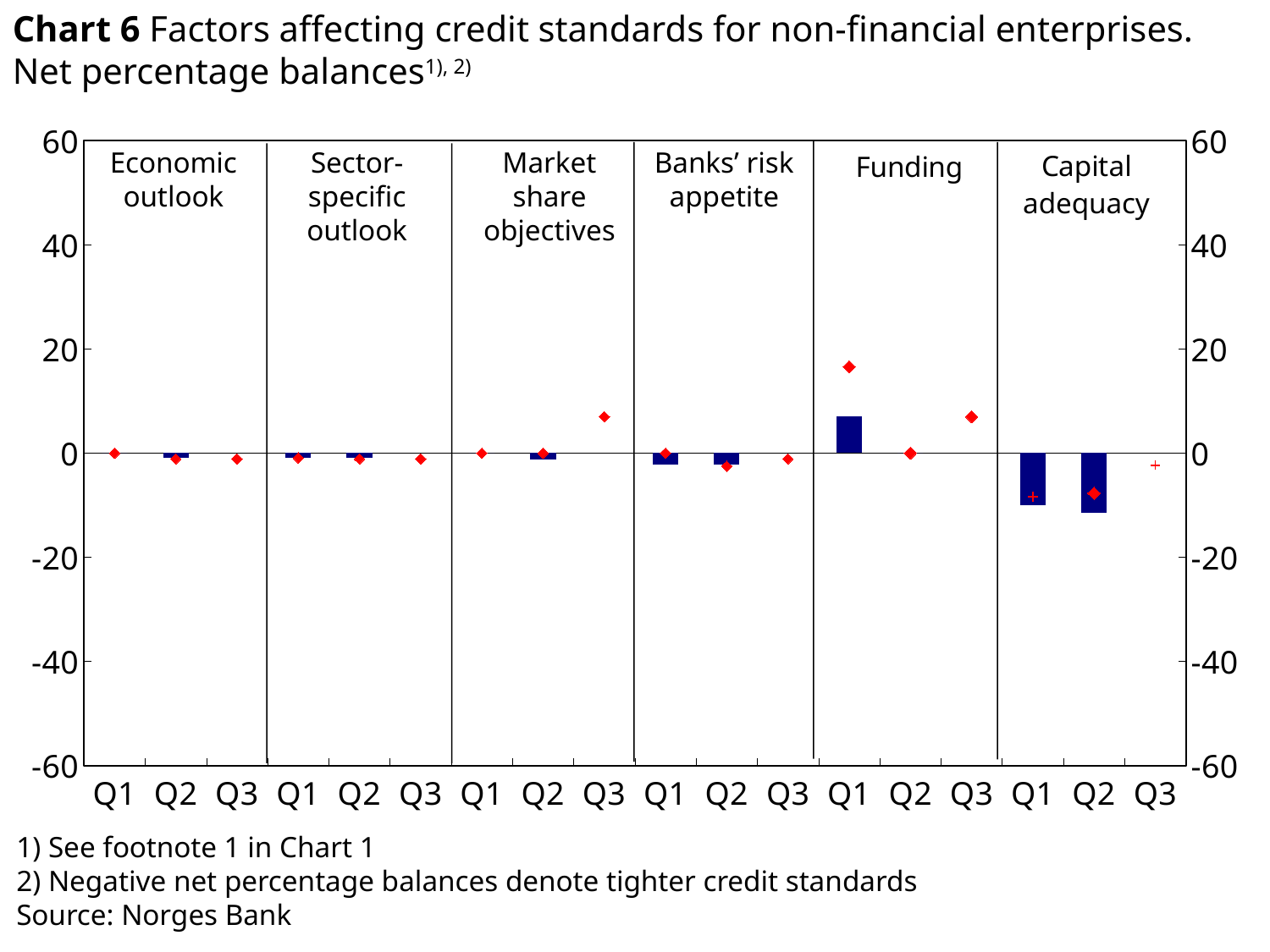
What kind of chart is shown on the slide? bar chart with red diamond markers (combination bar and line chart) What is the source given for the chart? Norges Bank Is the bar for Capital adequacy in Q2 greater or less than -20? greater How many quarters are shown for each factor in the chart? 3 How many factors (panels) are shown along the x axis of the chart? 6 Which factor has the highest bar in the chart? Funding Is the red marker for Funding in Q1 greater or less than 20? less Which factor has the lowest (most negative) bars in the chart? Capital adequacy Which is larger, the Q1 bar for Funding or the Q1 bar for Capital adequacy? Funding Is the bar for Capital adequacy in Q1 greater or less than 0? less Which is larger, the red marker for Funding in Q1 or the red marker for Market share objectives in Q3? Funding in Q1